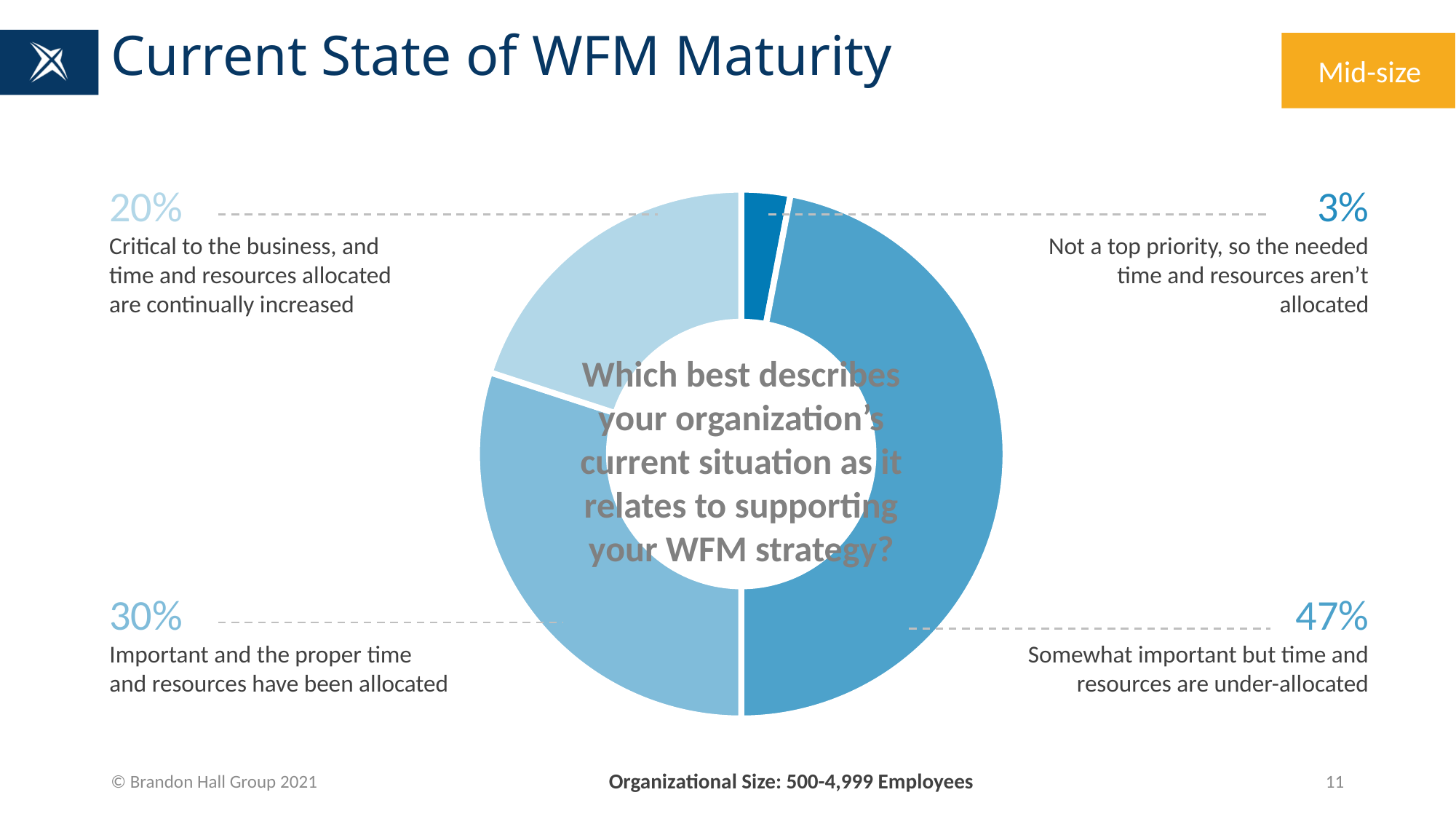
What percentage of respondents said WFM is important and the proper time and resources have been allocated? 30% How many response categories are shown in the chart? 4 What percentage of respondents said WFM is not a top priority, so the needed time and resources aren't allocated? 3% What question is written in the centre of the chart? Which best describes your organization's current situation as it relates to supporting your WFM strategy? What is the difference in percentage points between the 'Somewhat important but time and resources are under-allocated' share and the 'Important and the proper time and resources have been allocated' share? 17 What kind of chart is shown on the slide? Doughnut chart What organizational size does the slide footer say the data covers? 500-4,999 Employees What percentage of respondents said WFM is somewhat important but time and resources are under-allocated? 47% Which response has the smallest share of the chart? Not a top priority, so the needed time and resources aren't allocated Which response has the largest share of the chart? Somewhat important but time and resources are under-allocated Which is larger: the share for 'Critical to the business' or the share for 'Important and the proper time and resources have been allocated'? Important and the proper time and resources have been allocated What percentage of respondents said WFM is critical to the business, and time and resources allocated are continually increased? 20%